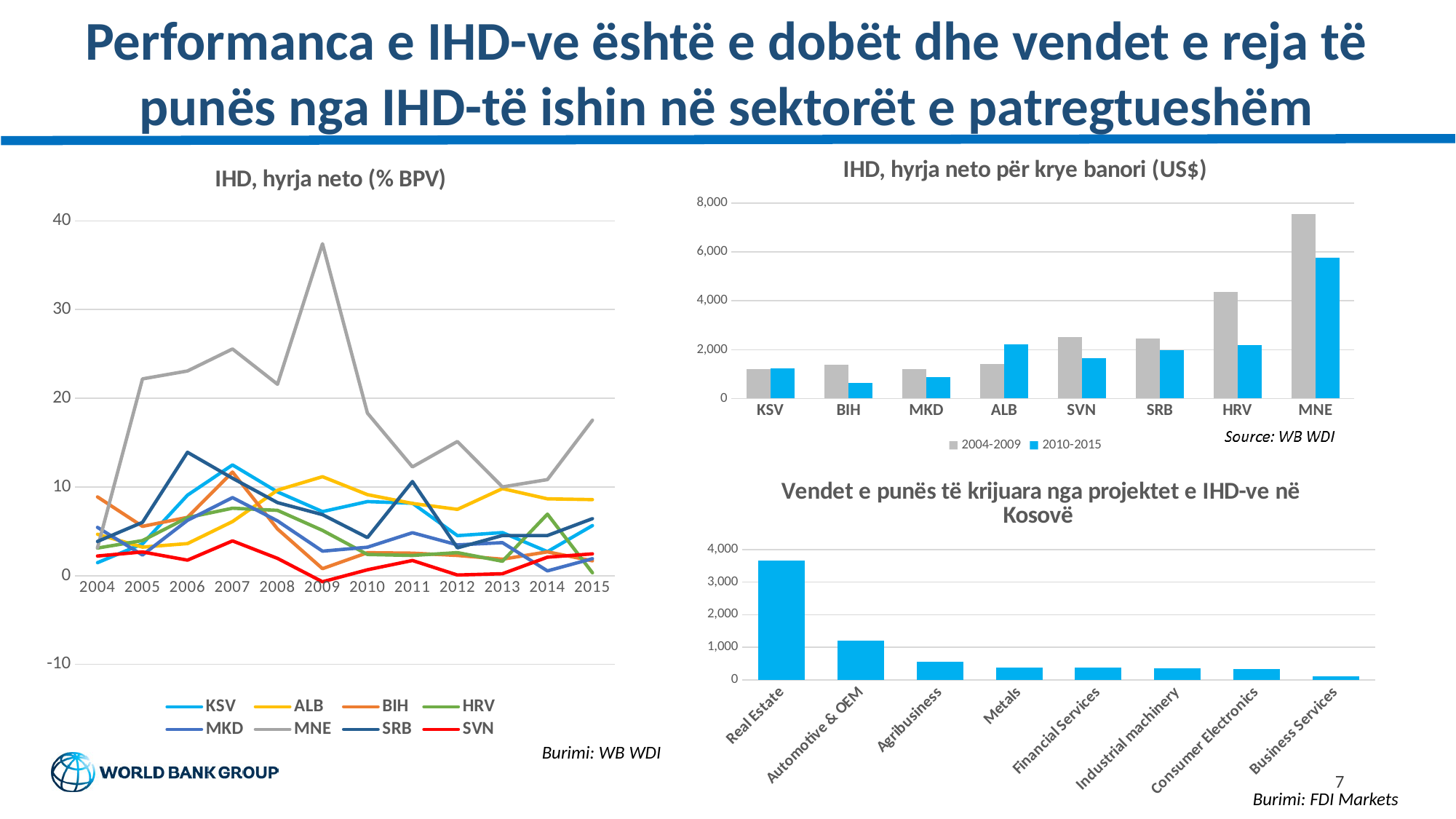
How many series does the legend of "IHD, hyrja neto për krye banori (US$)" list? 2 How many years are shown on the x axis of "IHD, hyrja neto (% BPV)"? 12 In "IHD, hyrja neto për krye banori (US$)", which country has the highest value for 2004-2009? MNE In "IHD, hyrja neto (% BPV)", which series reaches the highest value in 2009? MNE In "IHD, hyrja neto për krye banori (US$)", which is larger for ALB: 2004-2009 or 2010-2015? 2010-2015 What kind of chart is "IHD, hyrja neto (% BPV)"? line chart In "IHD, hyrja neto për krye banori (US$)", which country has the lowest value for 2010-2015? BIH In "Vendet e punës të krijuara nga projektet e IHD-ve në Kosovë", which sector has the highest value? Real Estate In "IHD, hyrja neto për krye banori (US$)", is the 2004-2009 value for MNE greater or less than 6,000? greater In "IHD, hyrja neto (% BPV)", is the value for MNE in 2009 greater or less than 30? greater In "Vendet e punës të krijuara nga projektet e IHD-ve në Kosovë", is the value for Real Estate greater or less than 3,000? greater How many series does the legend of "IHD, hyrja neto (% BPV)" list? 8